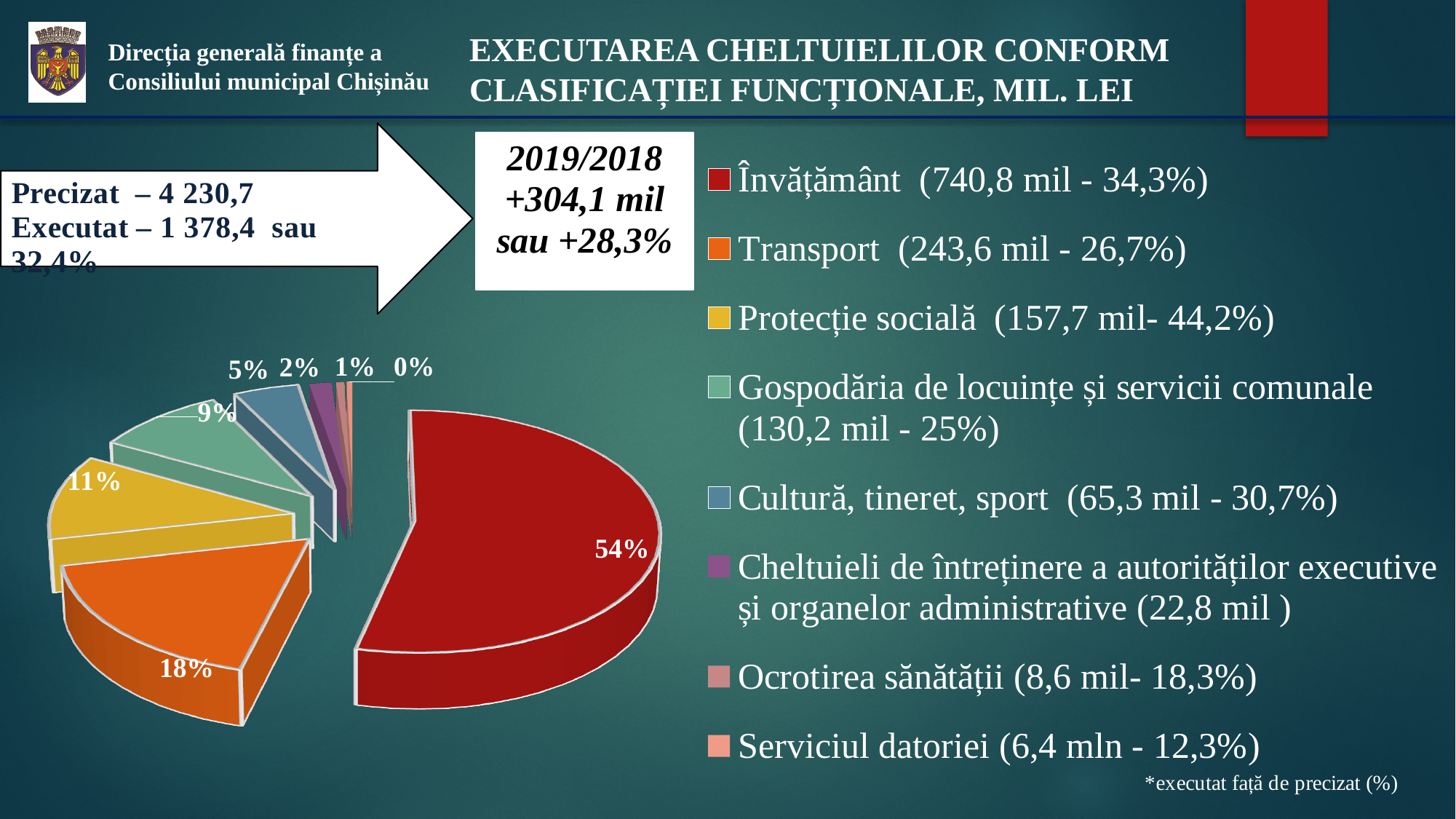
What share of the pie does Protecție socială (the yellow slice) represent? 11% Which category has the smallest slice of the pie, labelled 0%? Serviciul datoriei What share of the pie does Învățământ (the red slice) represent? 54% What kind of chart is shown on the slide? pie chart According to the legend, what amount in mil is shown for Cultură, tineret, sport? 65,3 mil What share of the pie does Transport (the orange slice) represent? 18% According to the legend, what amount in mil is shown for Învățământ? 740,8 mil Which category has the largest slice of the pie? Învățământ How many categories does the legend of the pie chart list? 8 By how many percentage points does the Învățământ slice exceed the Transport slice? 36 percentage points Which slice is larger: Transport or Protecție socială? Transport